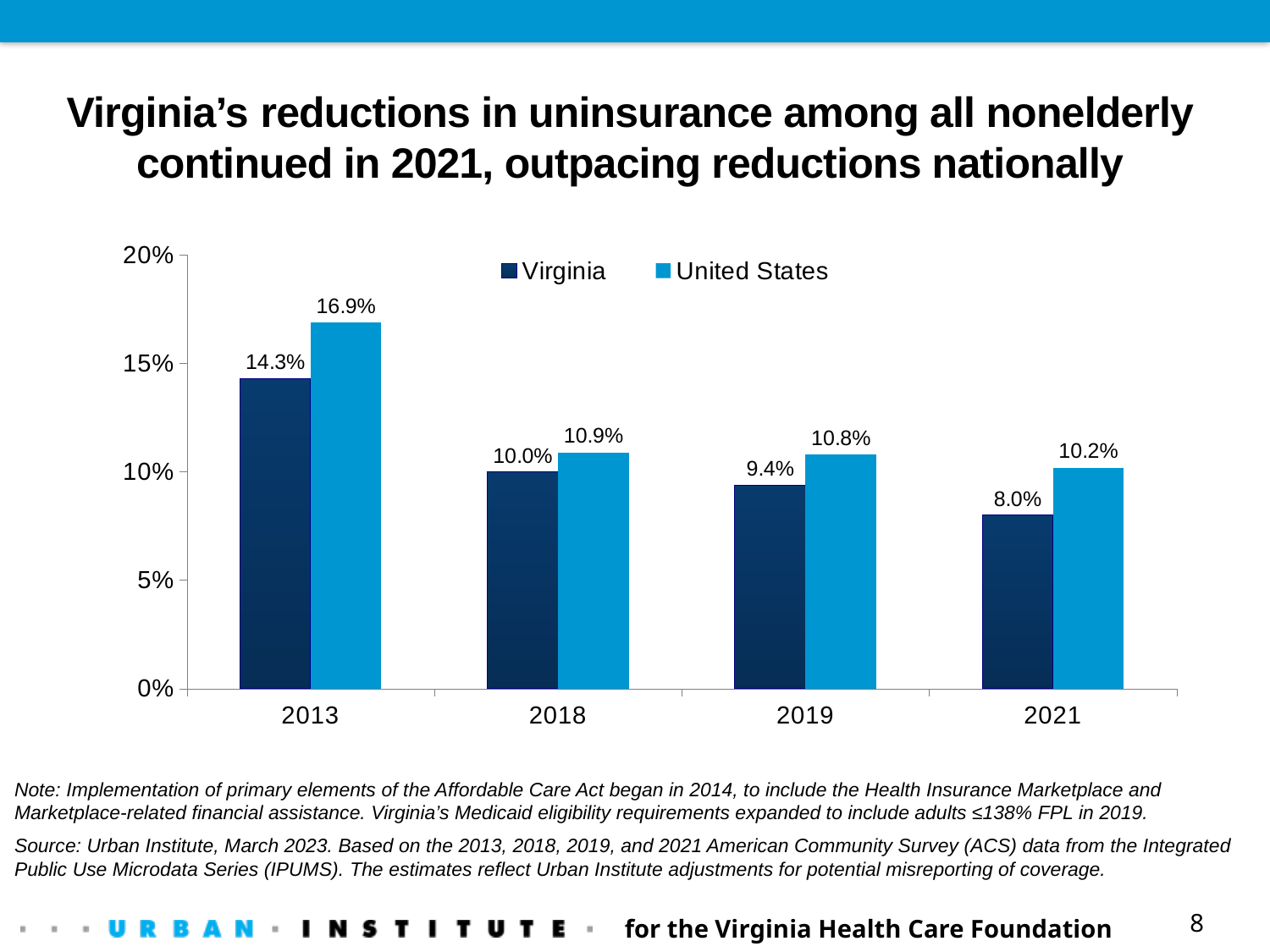
Do Virginia's uninsurance rates rise or fall from 2013 to 2021? Fall How many series does the legend list? 2 What is the difference between the United States and Virginia uninsurance rates in 2021? 2.2 percentage points Which had a higher uninsurance rate in 2018, Virginia or the United States? United States What was the United States uninsurance rate in 2021? 10.2% What kind of chart is shown on the slide? Bar chart What was Virginia's uninsurance rate in 2013? 14.3% What was Virginia's uninsurance rate in 2019? 9.4% How many years are shown on the x axis? 4 What is the difference between Virginia's uninsurance rate in 2013 and in 2021? 6.3 percentage points In which year was the United States uninsurance rate highest? 2013 In which year was Virginia's uninsurance rate lowest? 2021